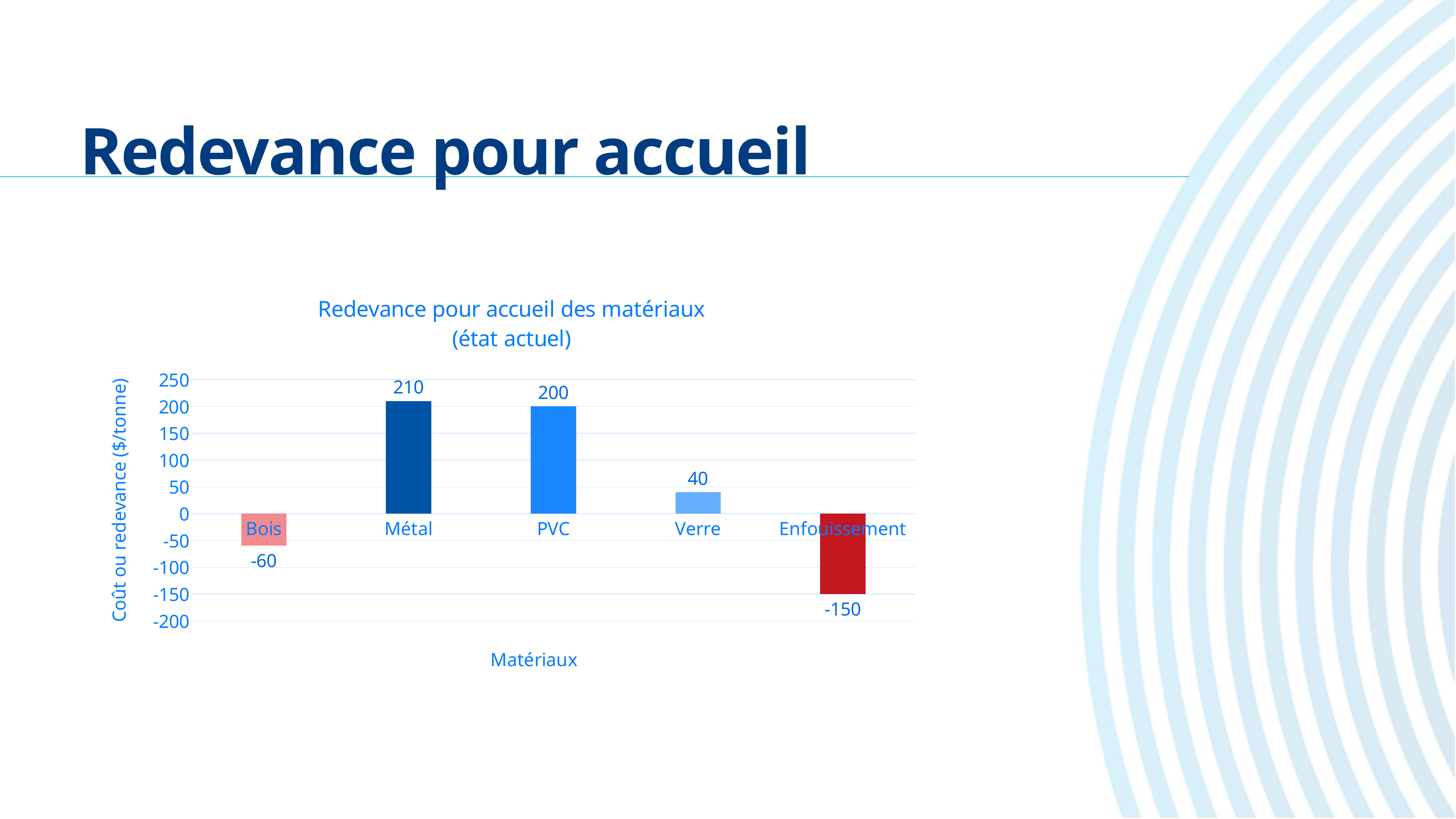
What is the value for Bois? -60 What is the label of the y axis? Coût ou redevance ($/tonne) What is the value for Métal? 210 How many categories are shown on the x axis? 5 What is the value for Enfouissement? -150 What is the difference between the values for PVC and Verre? 160 What is the difference between the values for Métal and PVC? 10 What kind of chart is shown on the slide? Bar chart Which category has the highest value? Métal Which is larger, the value for Bois or the value for Enfouissement? Bois Which category has the lowest value? Enfouissement What is the value for Verre? 40